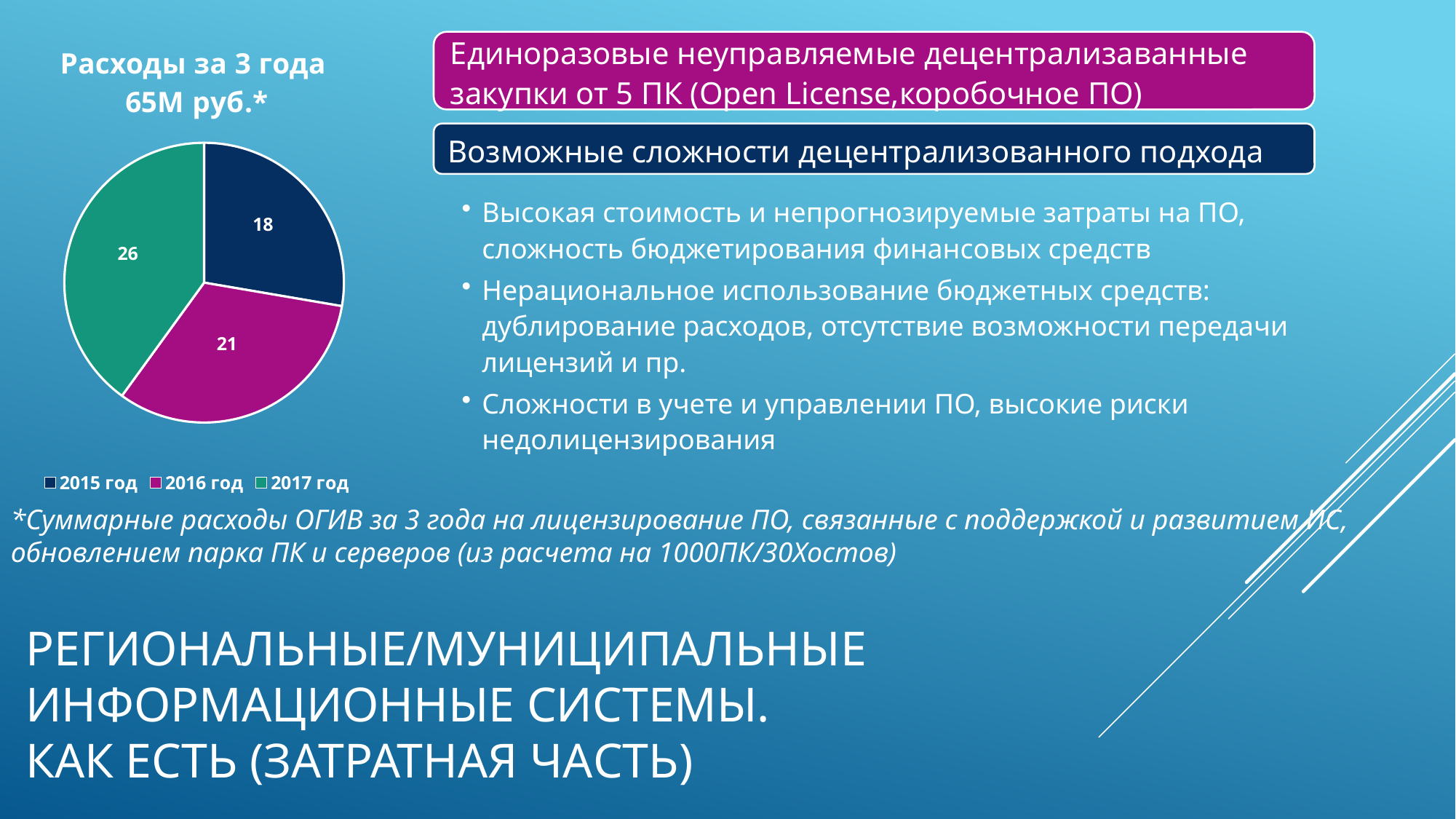
What is the value for 2017 год in the pie chart? 26 Which is larger, the value for 2016 год or the value for 2015 год? 2016 год What is the difference between the values for 2016 год and 2015 год? 3 What type of chart is shown on the slide? pie chart What is the sum of all three slices in the pie chart? 65 Which year has the largest slice in the pie chart? 2017 год Which year has the smallest slice in the pie chart? 2015 год What is the value for 2016 год in the pie chart? 21 What is the difference between the values for 2017 год and 2015 год? 8 How many slices does the pie chart have? 3 What is the value for 2015 год in the pie chart? 18 What is the title of the pie chart? Расходы за 3 года 65М руб.*